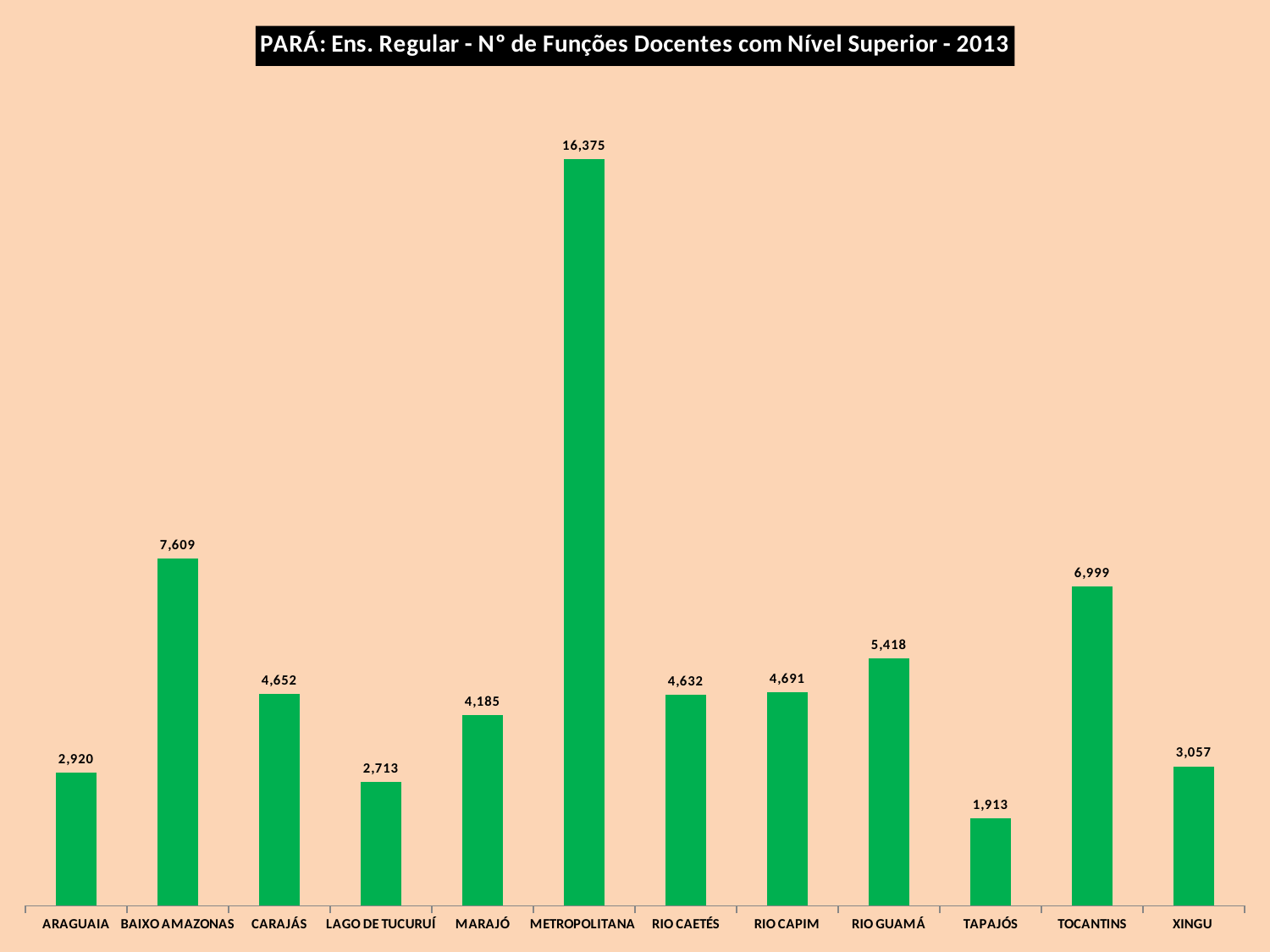
Which category has the lowest value? TAPAJÓS What is the value for TAPAJÓS? 1,913 How many categories are shown on the x axis? 12 What kind of chart is shown on the slide? Bar chart Which is larger, the value for RIO GUAMÁ or the value for RIO CAPIM? RIO GUAMÁ What is the title of the chart? PARÁ: Ens. Regular - N° de Funções Docentes com Nível Superior - 2013 What is the difference between the values for METROPOLITANA and TAPAJÓS? 14,462 What is the value for BAIXO AMAZONAS? 7,609 Which is larger, the value for ARAGUAIA or the value for XINGU? XINGU What is the value for METROPOLITANA? 16,375 What is the difference between the values for BAIXO AMAZONAS and TOCANTINS? 610 Which category has the highest value? METROPOLITANA